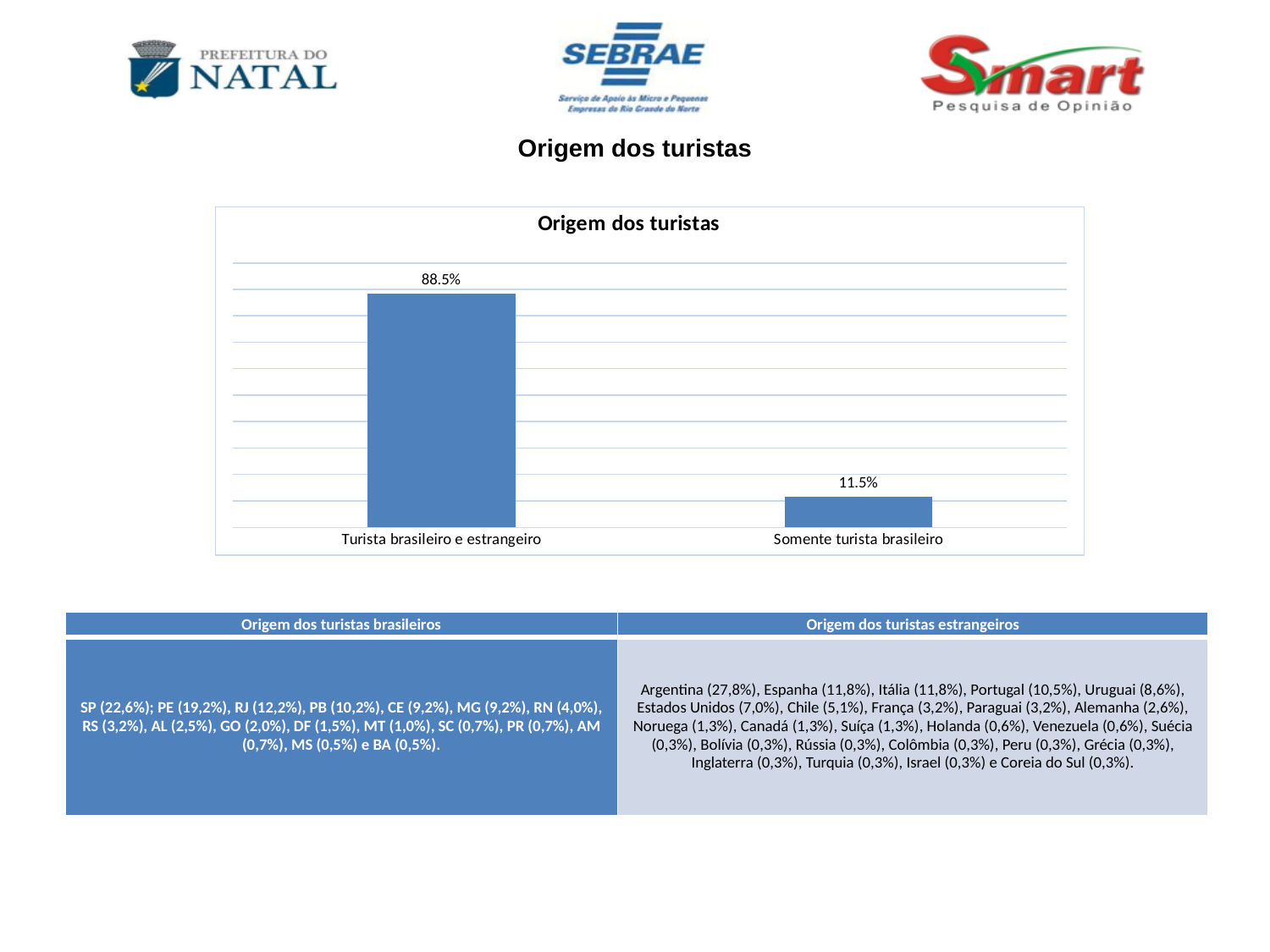
Which category has the highest value? Turista brasileiro e estrangeiro Which category has the lowest value? Somente turista brasileiro What is the value for "Somente turista brasileiro"? 11.5% How many categories are shown in the chart? 2 What is the value for "Turista brasileiro e estrangeiro"? 88.5% What is the difference between the values for "Turista brasileiro e estrangeiro" and "Somente turista brasileiro"? 77.0% What is the title of the chart? Origem dos turistas What colour are the bars in the chart? Blue Which is larger: the value for "Somente turista brasileiro" or the value for "Turista brasileiro e estrangeiro"? Turista brasileiro e estrangeiro What is the total of the two values shown in the chart? 100.0% What kind of chart is shown on the slide? Bar chart